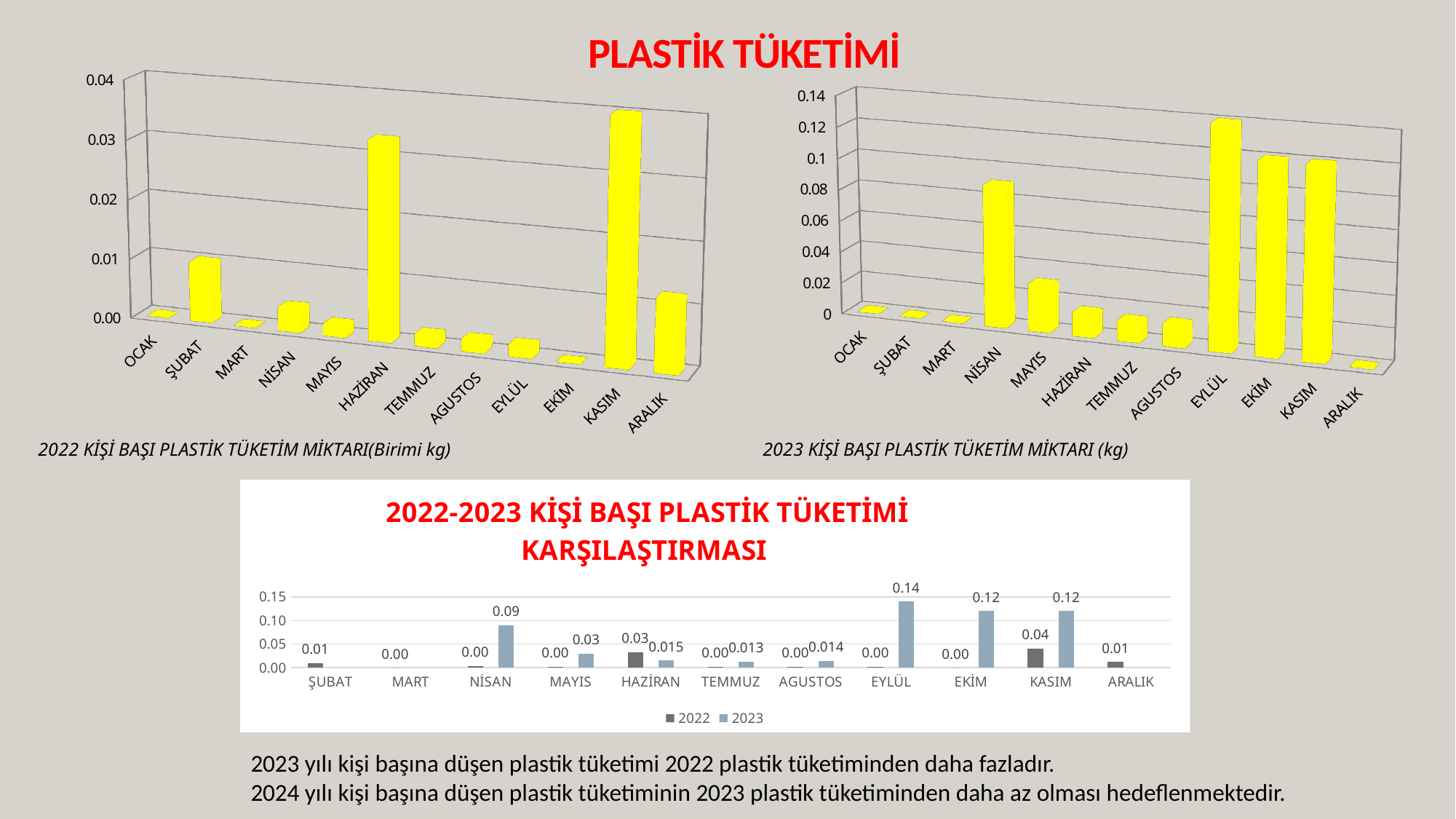
What kind of chart is the bottom comparison chart? Bar chart In the bottom chart titled '2022-2023 KİŞİ BAŞI PLASTİK TÜKETİMİ KARŞILAŞTIRMASI', what is the 2023 value for EYLÜL? 0.14 In the top-left chart '2022 KİŞİ BAŞI PLASTİK TÜKETİM MİKTARI', which month has the highest value? KASIM In the bottom comparison chart, what is the 2023 value for TEMMUZ? 0.013 In the bottom comparison chart, which month has the highest 2023 value? EYLÜL In the top-left 2022 chart, is the value for KASIM greater or less than 0.03? greater How many series does the legend of the bottom comparison chart list? 2 In the top-right chart '2023 KİŞİ BAŞI PLASTİK TÜKETİM MİKTARI', how many months are shown on the x axis? 12 In the bottom comparison chart, what is the 2022 value for KASIM? 0.04 In the bottom comparison chart, what is the 2023 value for NİSAN? 0.09 In the bottom comparison chart, which is larger for HAZİRAN: the 2022 value or the 2023 value? 2022 In the bottom comparison chart, what is the difference between the 2023 and 2022 values for KASIM? 0.08